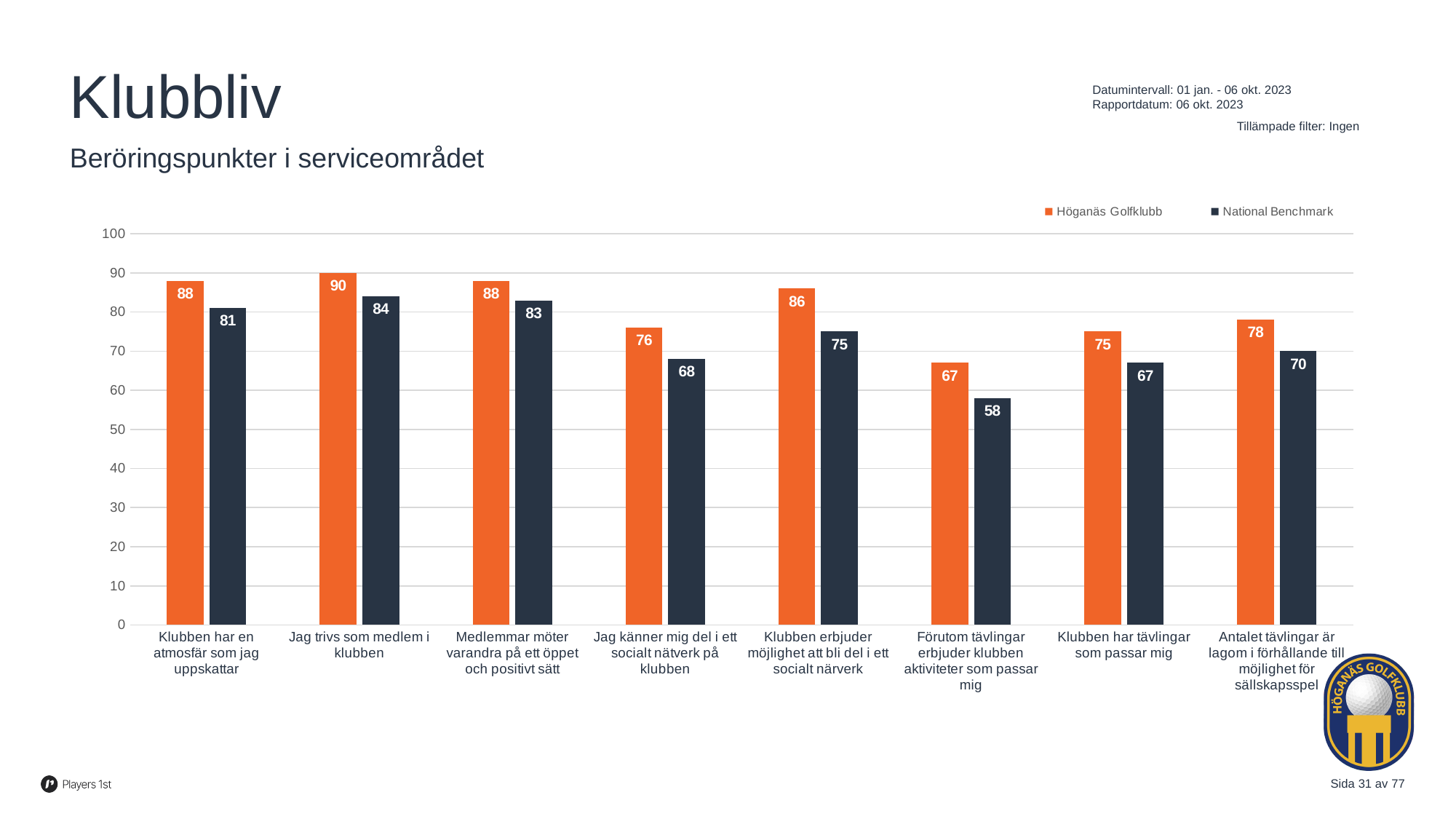
How many categories are shown on the x axis? 8 How many series does the legend list? 2 Which category has the highest Höganäs Golfklubb value? Jag trivs som medlem i klubben What is the Höganäs Golfklubb value for "Antalet tävlingar är lagom i förhållande till möjlighet för sällskapsspel"? 78 Which is larger for "Klubben erbjuder möjlighet att bli del i ett socialt närverk": Höganäs Golfklubb or National Benchmark? Höganäs Golfklubb Which category has the lowest National Benchmark value? Förutom tävlingar erbjuder klubben aktiviteter som passar mig Which colour represents National Benchmark in the legend? dark navy What is the National Benchmark value for "Förutom tävlingar erbjuder klubben aktiviteter som passar mig"? 58 Is the National Benchmark value for "Jag känner mig del i ett socialt nätverk på klubben" greater or less than 70? less What is the Höganäs Golfklubb value for "Jag trivs som medlem i klubben"? 90 What is the difference between the Höganäs Golfklubb and National Benchmark values for "Förutom tävlingar erbjuder klubben aktiviteter som passar mig"? 9 What kind of chart is shown on the slide? bar chart